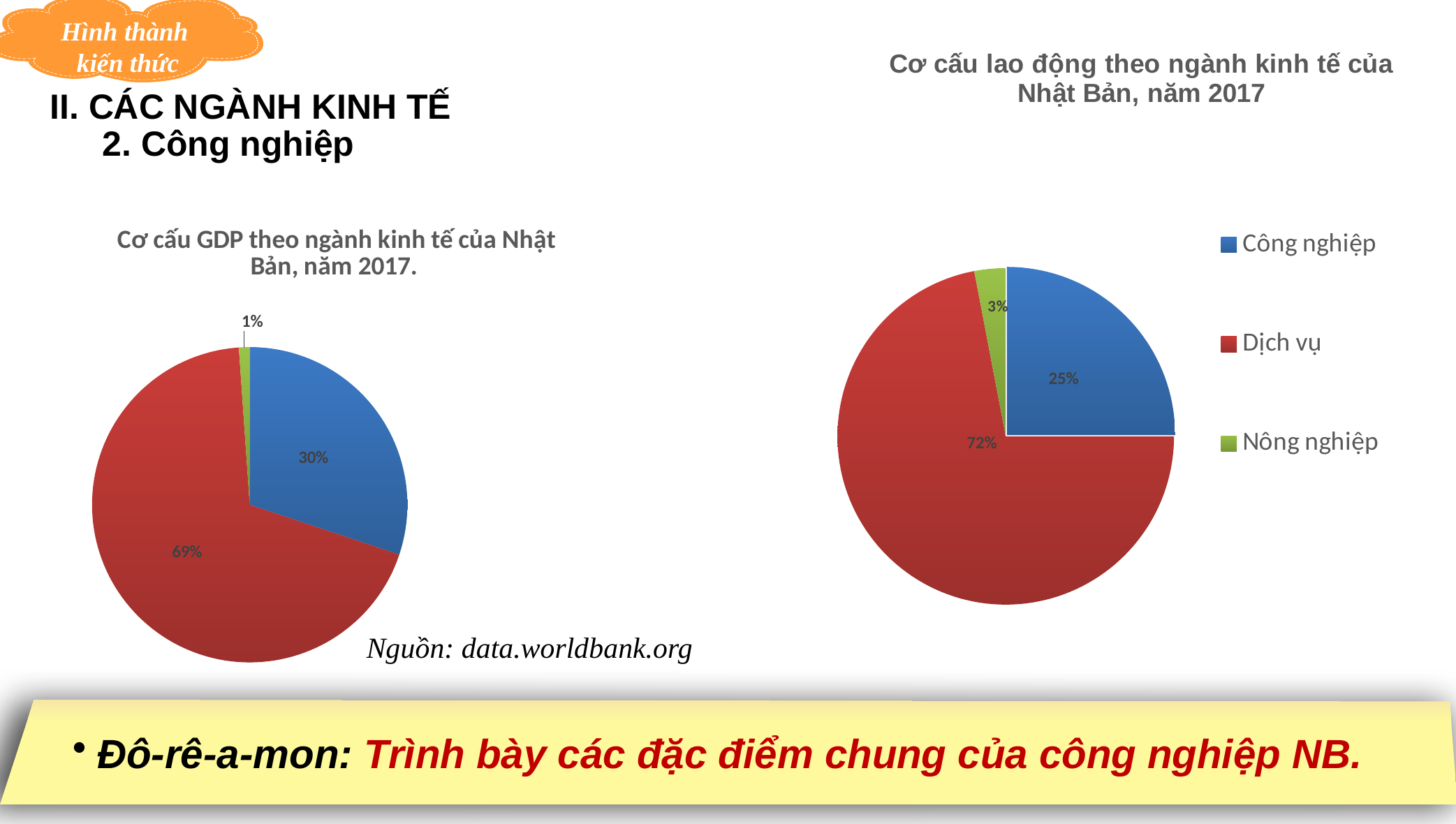
How many slices does the chart titled "Cơ cấu lao động theo ngành kinh tế của Nhật Bản, năm 2017" have? 3 According to the legend, which colour represents Nông nghiệp? Green In the chart titled "Cơ cấu GDP theo ngành kinh tế của Nhật Bản, năm 2017", what is the difference between the Dịch vụ share and the Công nghiệp share? 39% In the chart titled "Cơ cấu lao động theo ngành kinh tế của Nhật Bản, năm 2017", which sector has the smallest slice? Nông nghiệp How many entries does the legend on the right side of the slide list? 3 In the chart titled "Cơ cấu lao động theo ngành kinh tế của Nhật Bản, năm 2017", what share does Dịch vụ (red) have? 72% In the chart titled "Cơ cấu GDP theo ngành kinh tế của Nhật Bản, năm 2017", what share does Dịch vụ (red) have? 69% What type of chart is used for "Cơ cấu GDP theo ngành kinh tế của Nhật Bản, năm 2017"? Pie chart In the chart titled "Cơ cấu GDP theo ngành kinh tế của Nhật Bản, năm 2017", which sector has the largest slice? Dịch vụ Which is larger: the Công nghiệp share in the GDP chart (left) or the Công nghiệp share in the labour chart (right)? The GDP chart (30%) In the chart titled "Cơ cấu lao động theo ngành kinh tế của Nhật Bản, năm 2017", what share does Nông nghiệp (green) have? 3% In the chart titled "Cơ cấu GDP theo ngành kinh tế của Nhật Bản, năm 2017", what share does Công nghiệp (blue) have? 30%